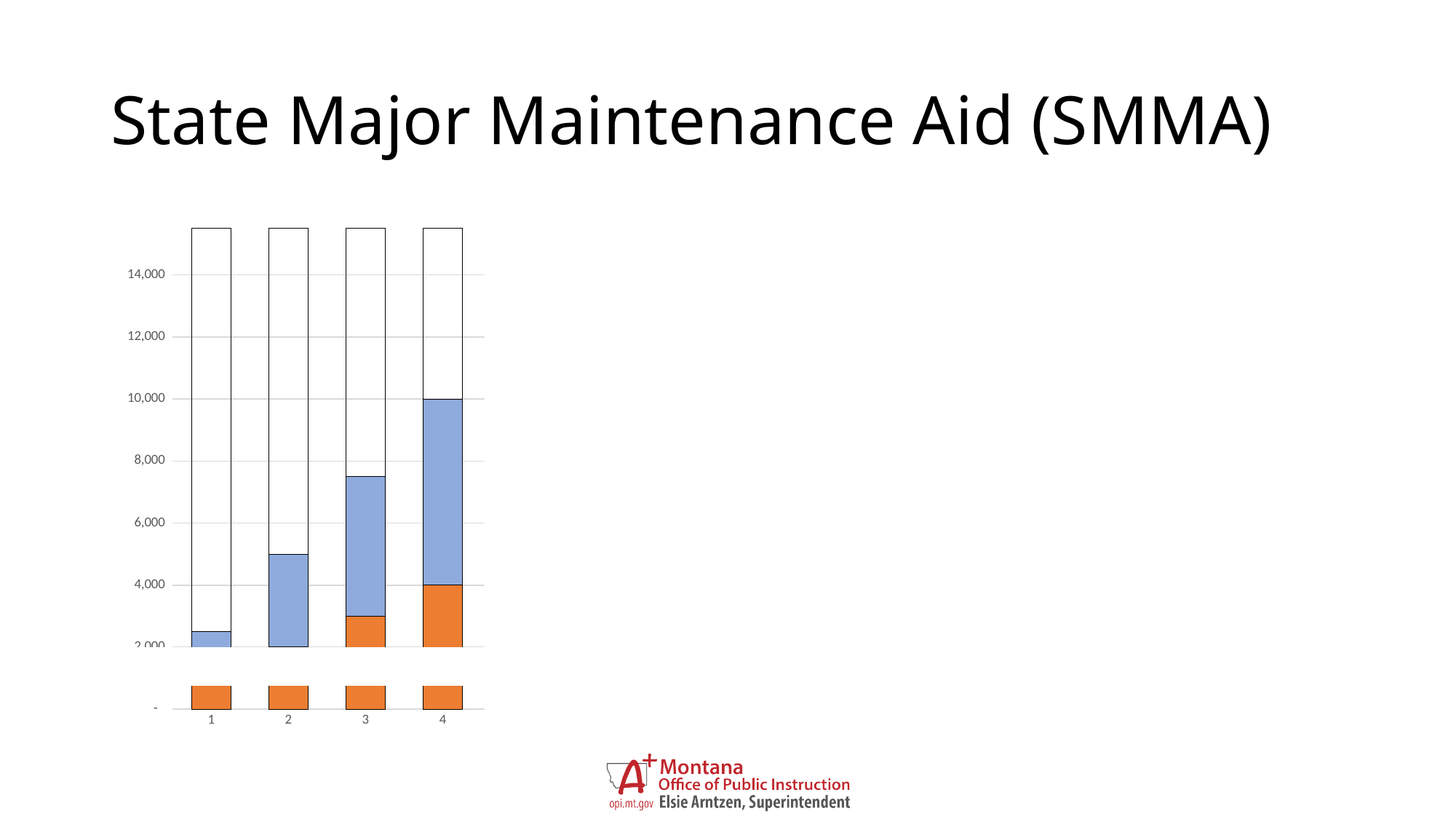
Is the top of the blue segment for category 2 greater or less than 4,000? greater Do the tops of the blue segments rise or fall from category 1 to category 4? rise What is the highest value labelled on the vertical axis? 14,000 At what value on the vertical axis does the top of the blue segment for category 4 land? 10,000 At what value on the vertical axis does the top of the orange segment for category 4 land? 4,000 Which category has the lowest top of the blue segment? 1 How many categories are shown on the x axis of the chart? 4 Is the top of the orange segment for category 3 greater or less than 4,000? less What kind of chart is shown on the slide? bar chart Is the top of the blue segment for category 1 greater or less than 4,000? less Which category has the highest top of the blue segment? 4